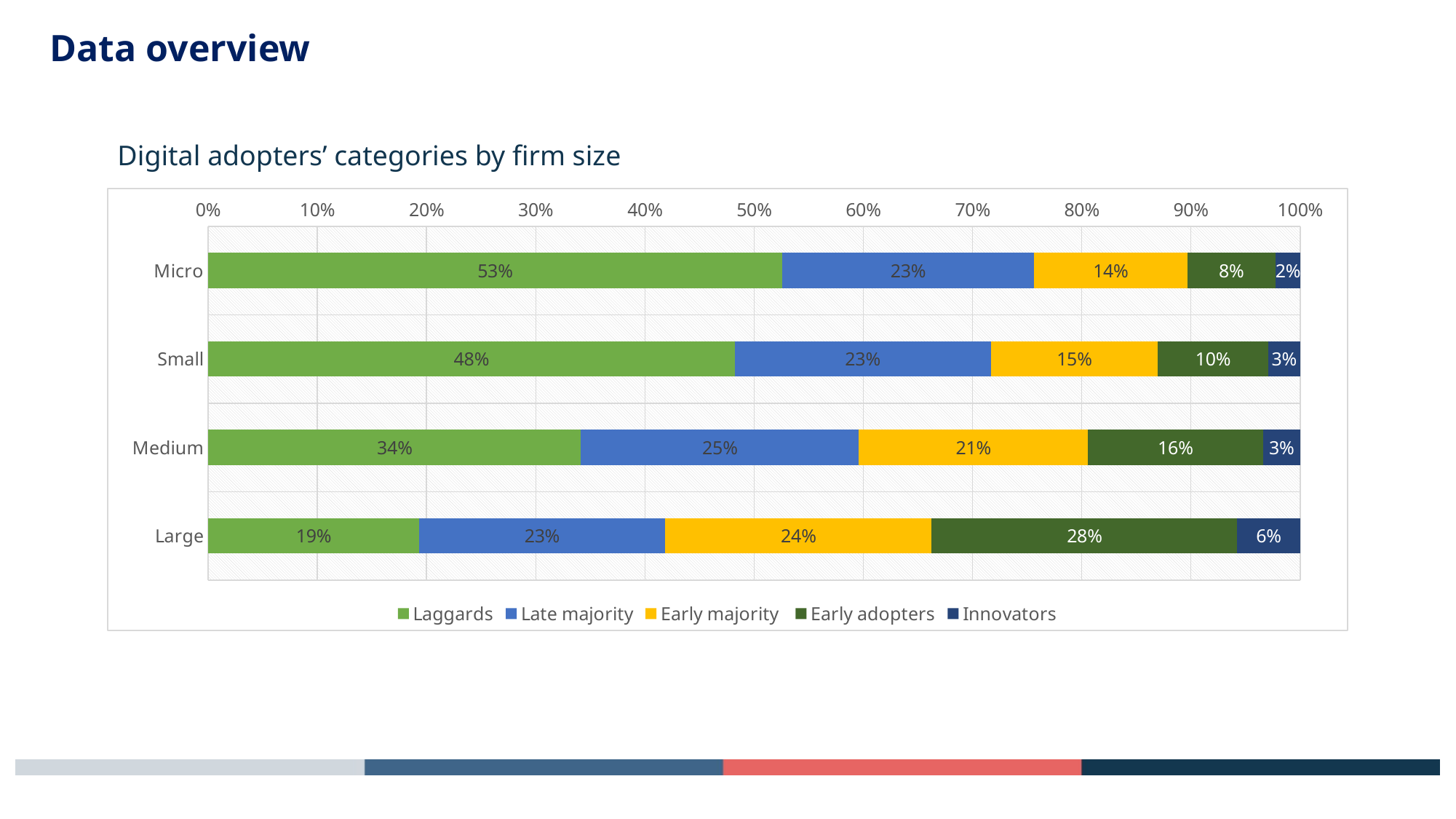
How many series does the legend list? 5 Which firm size has the lowest share of Innovators? Micro What percentage of Micro firms are Laggards? 53% How many firm size categories are shown on the chart? 4 What is the difference between the Laggards share for Micro firms and for Large firms? 34% What is the title of the chart? Digital adopters' categories by firm size What kind of chart is shown on the slide? Stacked bar chart What percentage of Medium firms are Early majority? 21% Which firm size has the highest share of Laggards? Micro What percentage of Small firms are Innovators? 3% Which is larger: the Early adopters share for Medium firms or for Small firms? Medium What percentage of Large firms are Early adopters? 28%